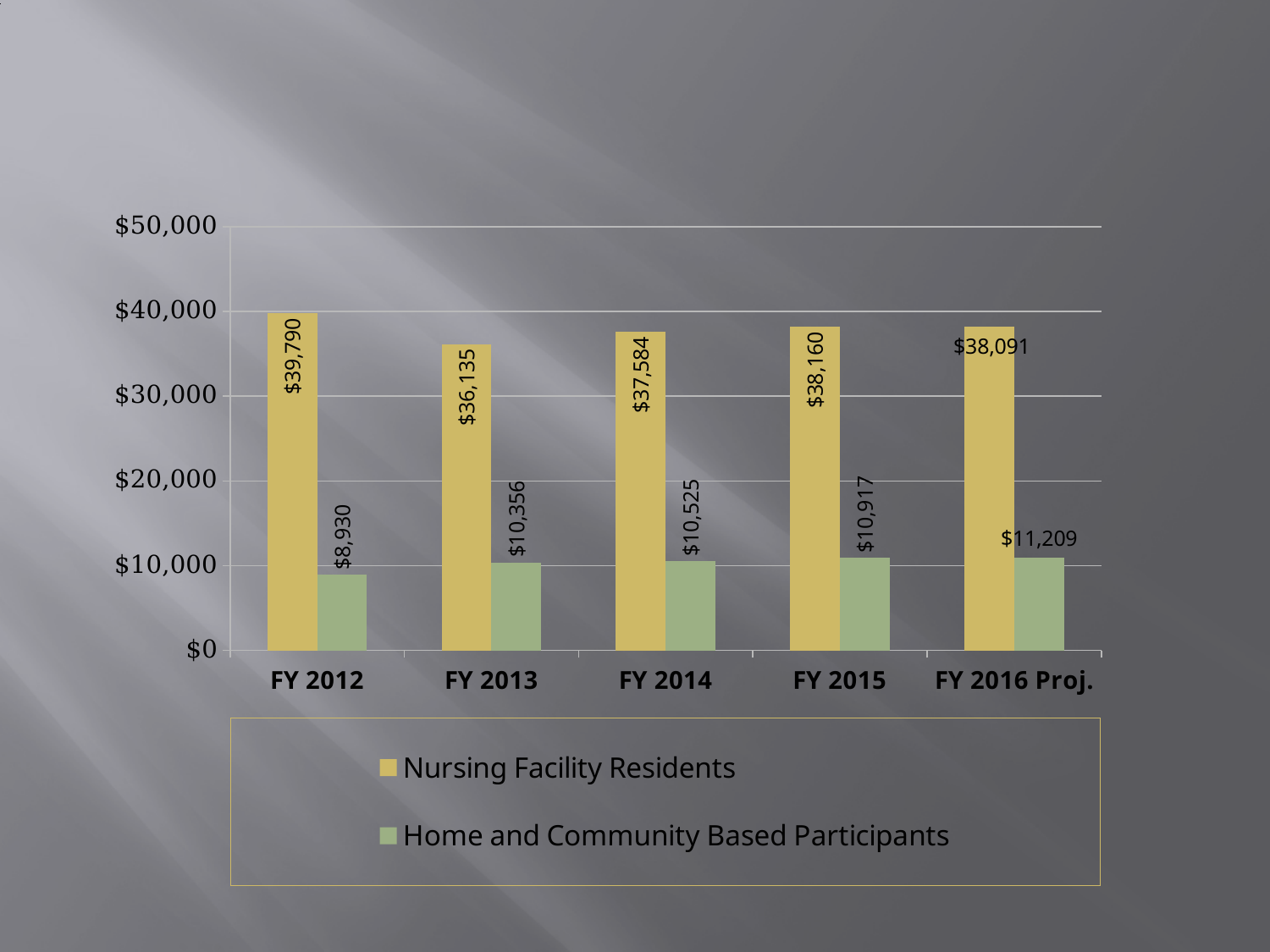
How many series does the legend list? 2 Is the value for Home and Community Based Participants in FY 2012 greater or less than $10,000? less How many fiscal years are shown on the x axis? 5 Which is larger: the Nursing Facility Residents value in FY 2013 or in FY 2014? FY 2014 Which fiscal year has the lowest value for Home and Community Based Participants? FY 2012 What kind of chart is shown on the slide? bar chart What is the value for Nursing Facility Residents in FY 2012? $39,790 What is the difference between the Nursing Facility Residents value and the Home and Community Based Participants value in FY 2015? $27,243 What is the value for Nursing Facility Residents in FY 2016 Proj.? $38,091 What is the value for Home and Community Based Participants in FY 2014? $10,525 Do the values for Home and Community Based Participants rise or fall from FY 2012 to FY 2016 Proj.? rise Which fiscal year has the highest value for Nursing Facility Residents? FY 2012